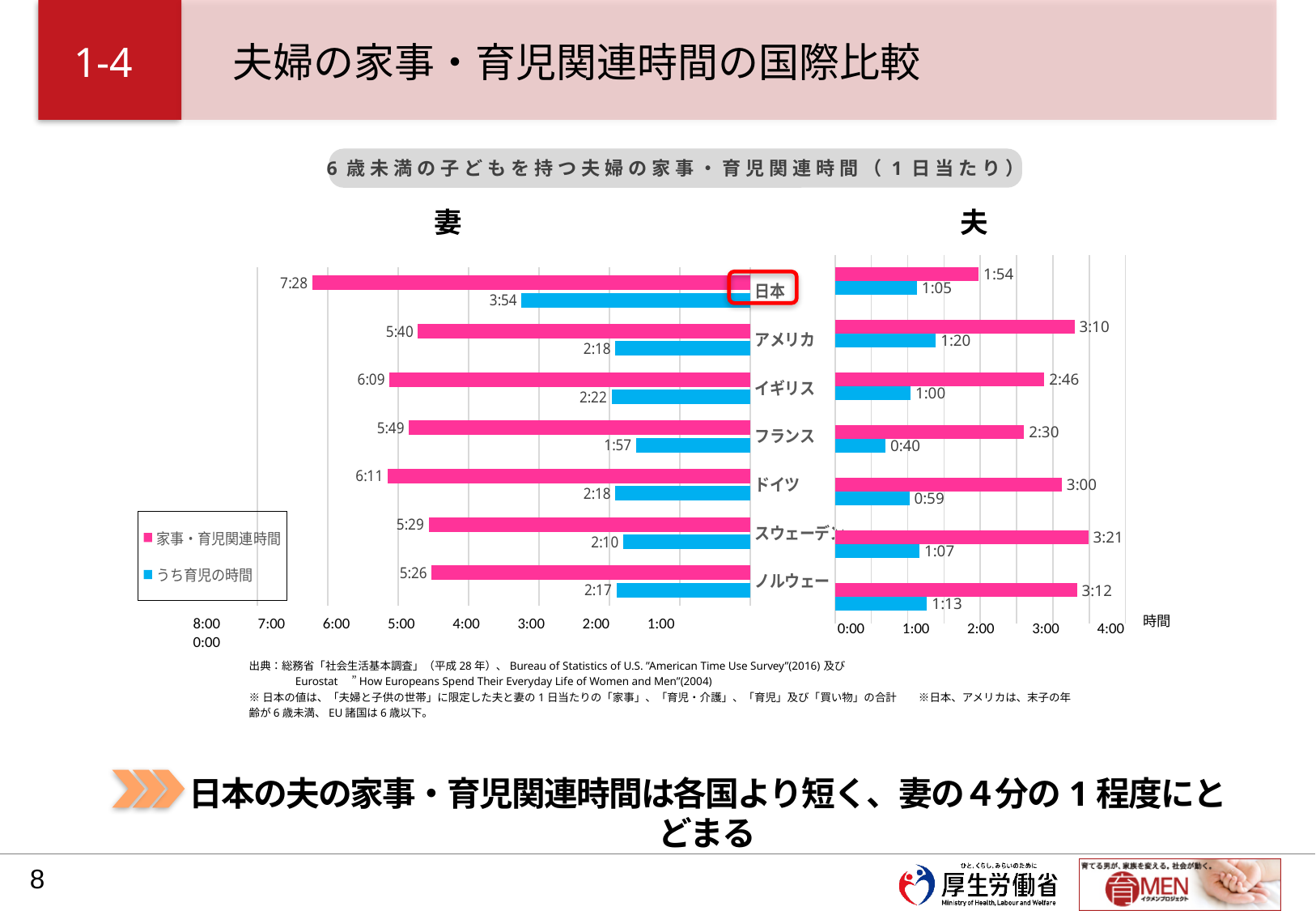
On the 妻 (wife) side of the chart, which country has the highest 家事・育児関連時間? 日本 On the 妻 (wife) side of the chart, what is the 家事・育児関連時間 value for 日本? 7:28 On the 夫 (husband) side of the chart, which country has the lowest 家事・育児関連時間? 日本 What type of chart is shown on the slide? Bar chart On the 夫 (husband) side of the chart, which country has the highest 家事・育児関連時間? スウェーデン On the 夫 (husband) side of the chart, which is larger: the 家事・育児関連時間 for アメリカ or for ドイツ? アメリカ On the 妻 (wife) side of the chart, what is the difference between 家事・育児関連時間 (7:28) and うち育児の時間 (3:54) for 日本? 3:34 How many series does the chart legend list? 2 On the 妻 (wife) side of the chart, what is the うち育児の時間 value for イギリス? 2:22 On the 夫 (husband) side of the chart, what is the うち育児の時間 value for フランス? 0:40 On the 夫 (husband) side of the chart, what is the 家事・育児関連時間 value for 日本? 1:54 How many countries are shown in the chart? 7